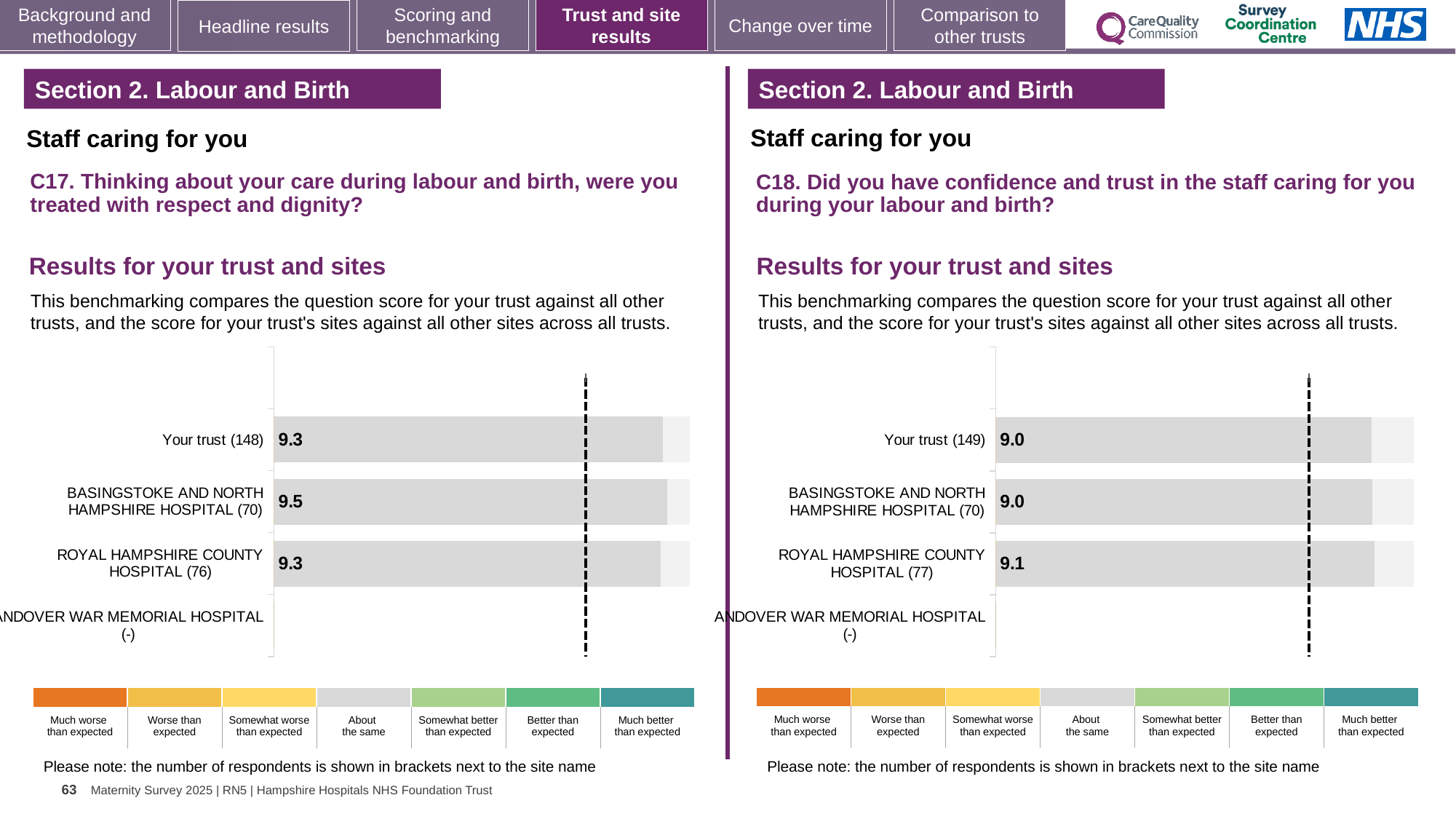
What kind of chart is used for the C18 results on the right? bar chart In the C18 chart on the right, which site has the highest score? ROYAL HAMPSHIRE COUNTY HOSPITAL (77) In the C17 chart on the left, what is the score for Your trust (148)? 9.3 In the C18 chart on the right, is the score for Your trust (149) larger or smaller than the score for ROYAL HAMPSHIRE COUNTY HOSPITAL (77)? smaller In the C17 chart on the left, what is the difference between the score for BASINGSTOKE AND NORTH HAMPSHIRE HOSPITAL (70) and the score for ROYAL HAMPSHIRE COUNTY HOSPITAL (76)? 0.2 In the C18 chart on the right, how many respondents are shown in brackets for Your trust? 149 In the C17 chart on the left, which site has the highest score? BASINGSTOKE AND NORTH HAMPSHIRE HOSPITAL (70) In the C18 chart on the right, what is the score for Your trust (149)? 9.0 In the C18 chart on the right, what is the score for ROYAL HAMPSHIRE COUNTY HOSPITAL (77)? 9.1 In the C17 chart on the left, what is the score for BASINGSTOKE AND NORTH HAMPSHIRE HOSPITAL (70)? 9.5 In the C17 chart on the left, how many rows (sites including Your trust) are listed on the axis? 4 In the C17 chart on the left, which site shows no score, marked with (-)? ANDOVER WAR MEMORIAL HOSPITAL